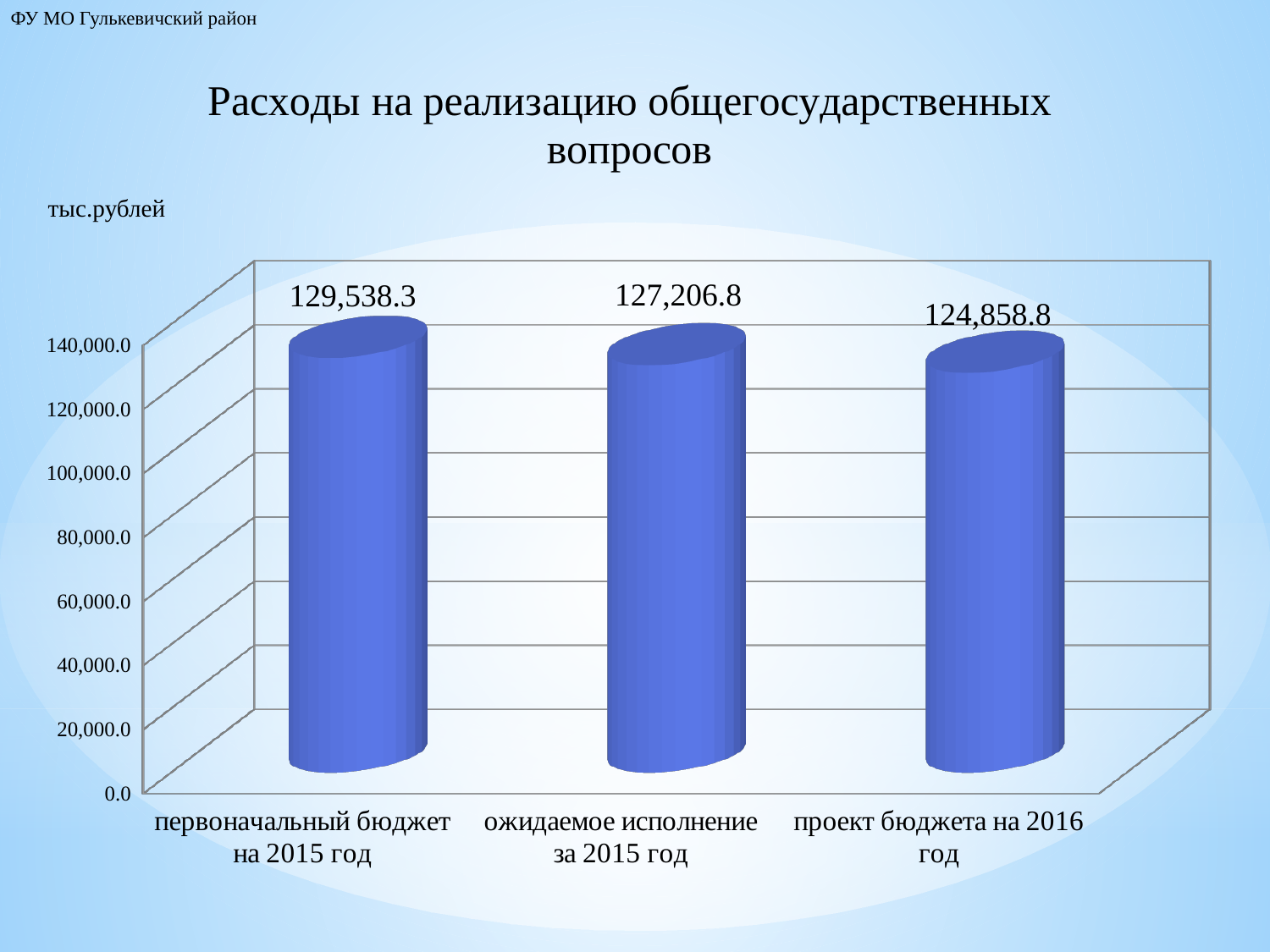
Which is larger: the value for «ожидаемое исполнение за 2015 год» or the value for «проект бюджета на 2016 год»? ожидаемое исполнение за 2015 год What is the value for «проект бюджета на 2016 год»? 124,858.8 What is the difference between the value for «первоначальный бюджет на 2015 год» and the value for «проект бюджета на 2016 год»? 4,679.5 Which category has the highest value? первоначальный бюджет на 2015 год Which category has the lowest value? проект бюджета на 2016 год What is the value for «первоначальный бюджет на 2015 год»? 129,538.3 Do the values rise or fall from left to right along the x axis? fall How many categories are shown on the chart? 3 Is the value for «проект бюджета на 2016 год» greater or less than 120,000.0? greater What is the value for «ожидаемое исполнение за 2015 год»? 127,206.8 What is the difference between the value for «первоначальный бюджет на 2015 год» and the value for «ожидаемое исполнение за 2015 год»? 2,331.5 What kind of chart is shown on the slide? bar chart